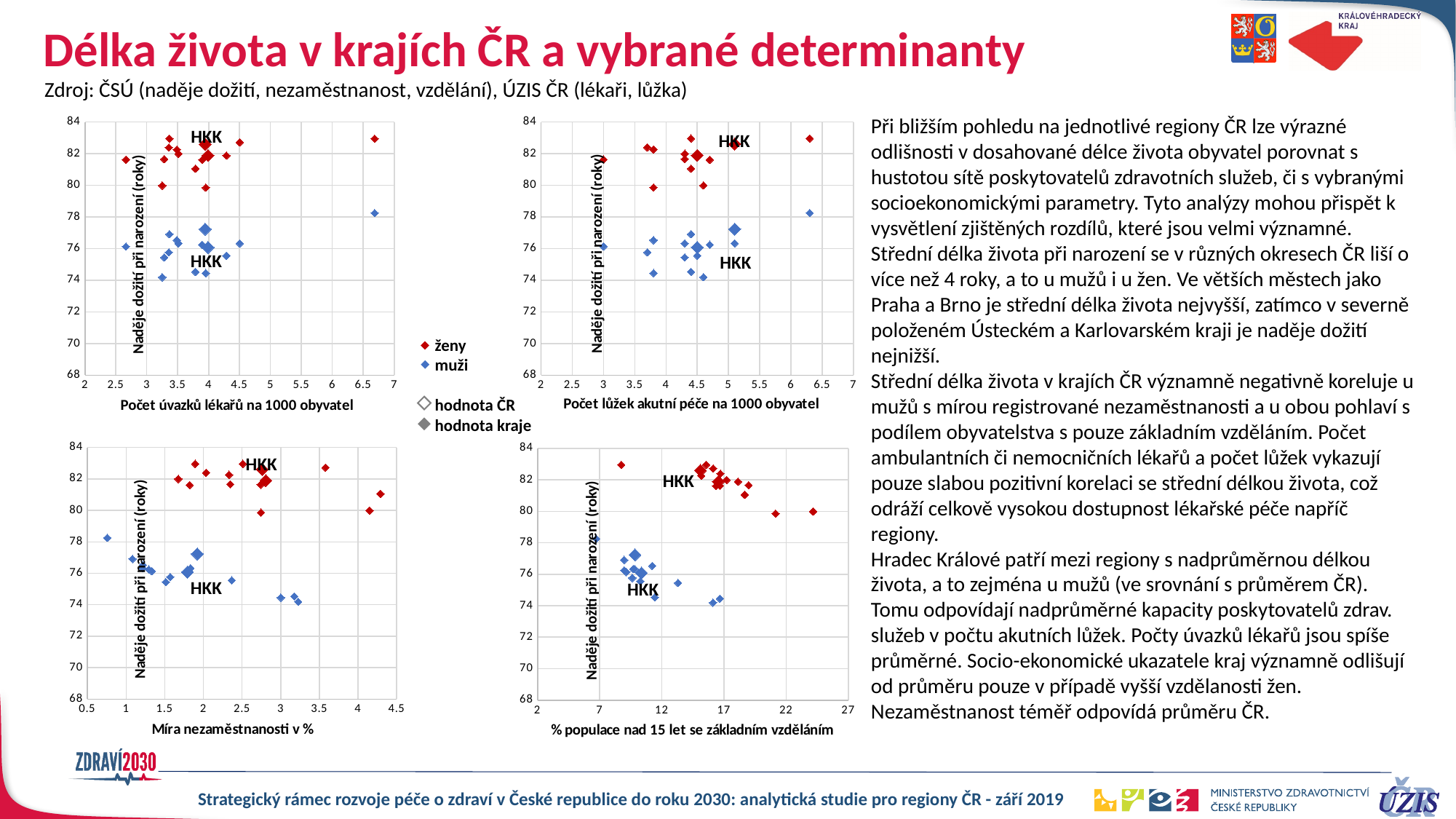
In the bottom-left chart (Míra nezaměstnanosti v %), is the HKK muži value greater or less than 78? less How many series does the shared legend list? 4 In the top-left chart (Počet úvazků lékařů na 1000 obyvatel), which is larger for HKK: the ženy value or the muži value? ženy In the top-left chart (Počet úvazků lékařů na 1000 obyvatel), is the lowest ženy value greater or less than 78? greater In the bottom-right chart (% populace nad 15 let se základním vzděláním), do the ženy values rise or fall as the share of population with basic education increases? fall What is the x-axis title of the bottom-right chart? % populace nad 15 let se základním vzděláním In the top-right chart (Počet lůžek akutní péče na 1000 obyvatel), is the HKK ženy value greater or less than 80? greater How many charts are shown on the slide? 4 What kind of chart is the top-left chart with x axis 'Počet úvazků lékařů na 1000 obyvatel'? scatter chart In the bottom-left chart (Míra nezaměstnanosti v %), which series has the higher values overall: ženy or muži? ženy